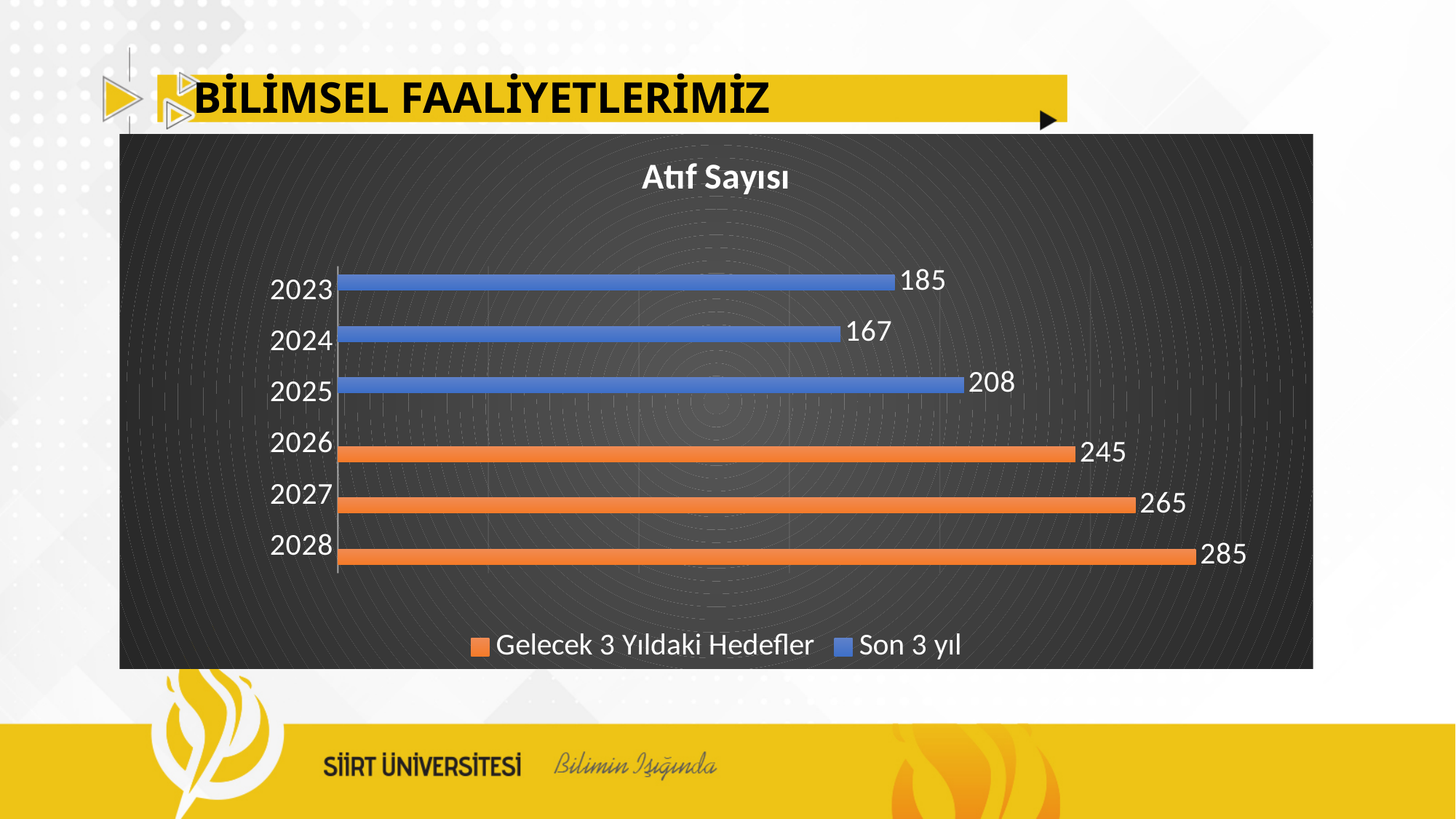
What is the difference between the values for 2025 and 2024? 41 What kind of chart is shown on the slide? Bar chart How many series does the legend list? 2 Which is larger, the value for 2026 or the value for 2025? 2026 What is the value for 2025 in the Atıf Sayısı chart? 208 Which series is shown in orange in the legend? Gelecek 3 Yıldaki Hedefler What is the value for 2023 in the Atıf Sayısı chart? 185 What is the difference between the values for 2028 and 2023? 100 How many years are shown in the Atıf Sayısı chart? 6 What is the value for 2028 in the Atıf Sayısı chart? 285 Which year has the highest value in the Atıf Sayısı chart? 2028 Which year has the lowest value in the Atıf Sayısı chart? 2024